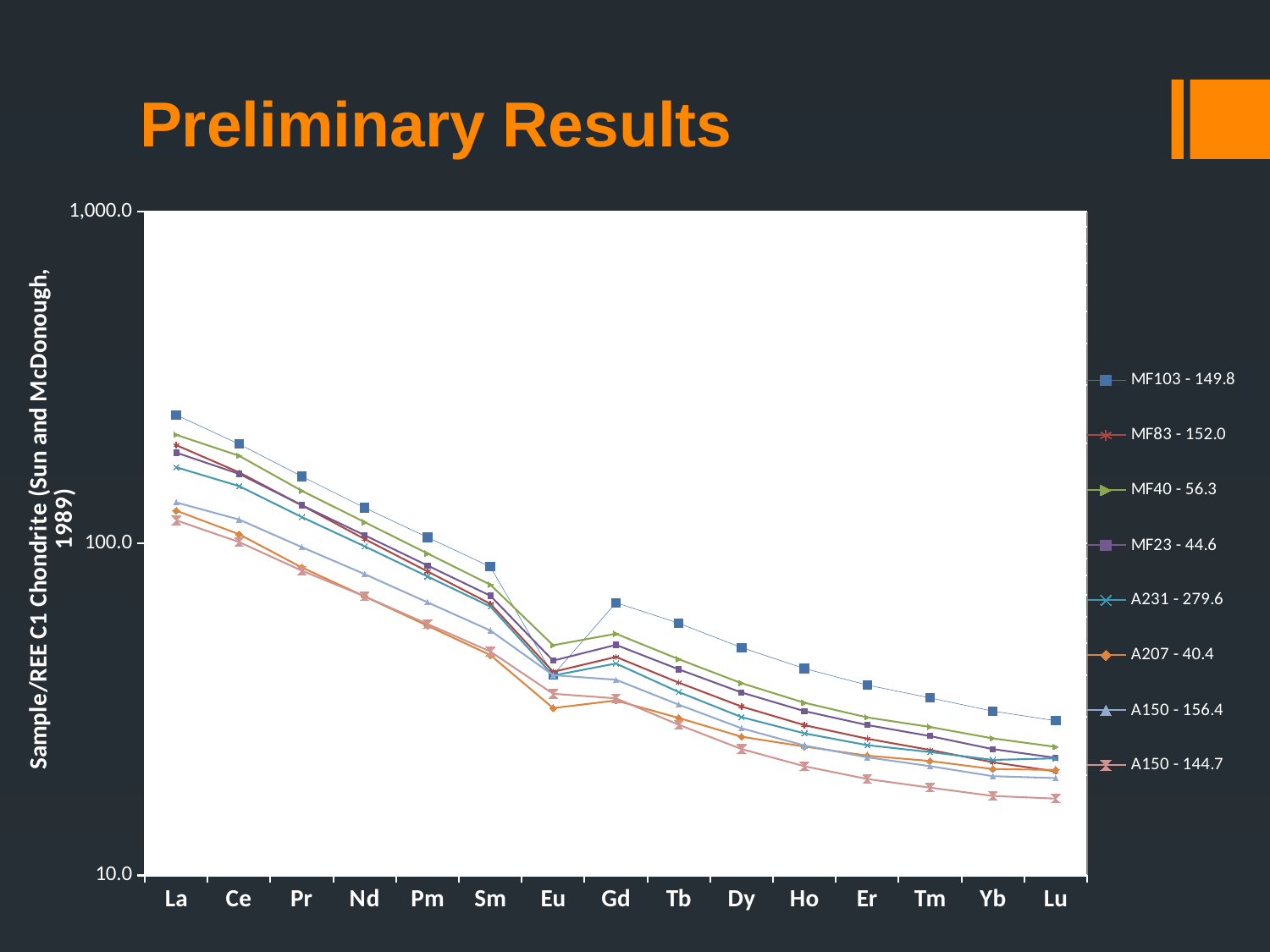
What is the label on the y axis of the chart? Sample/REE C1 Chondrite (Sun and McDonough, 1989) How many elements (categories) are shown along the x axis? 15 Is the value for MF103 - 149.8 at La greater or less than 100.0? greater Do the values generally rise or fall from La to Lu? Fall At which element do all the lines show a sharp dip? Eu What kind of chart is shown on the slide? Line chart How many series does the legend list? 8 Is the value for MF103 - 149.8 at Nd greater or less than 100.0? greater Is the value for A150 - 144.7 at Lu greater or less than 100.0? less At Gd, which is larger: the value for MF103 - 149.8 or the value for A150 - 144.7? MF103 - 149.8 Which series has the highest value at La? MF103 - 149.8 Which series has the lowest value at Lu? A150 - 144.7